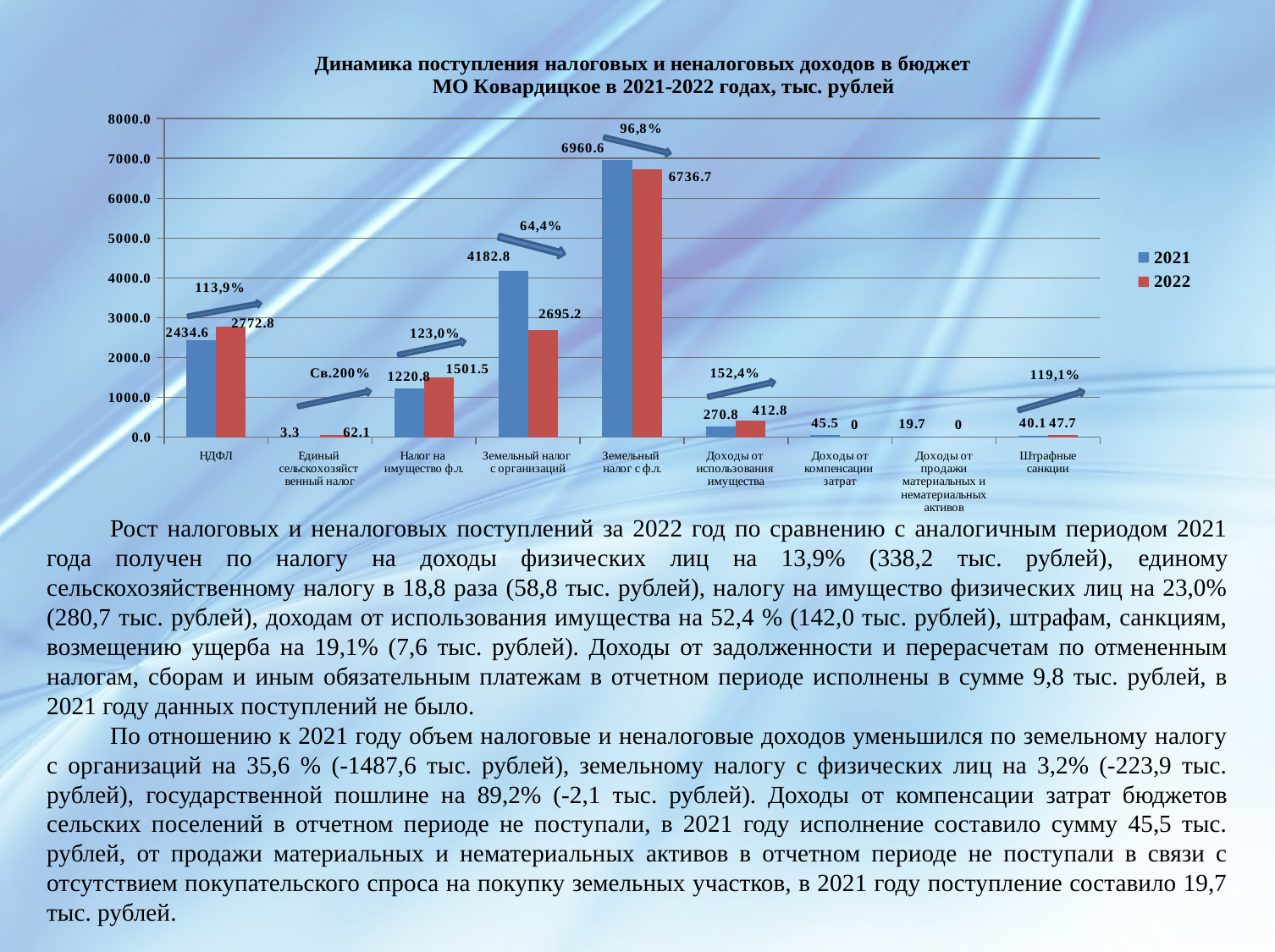
Is the 2022 value for Земельный налог с ф.л. greater or less than 6000.0? greater Which category has the highest 2021 value? Земельный налог с ф.л. What is the 2022 value for Доходы от компенсации затрат? 0 What is the 2021 value for НДФЛ? 2434.6 How many series does the legend list? 2 Which is larger for Налог на имущество ф.л.: the 2021 value or the 2022 value? 2022 How many categories are shown on the x axis? 9 What is the 2022 value for Доходы от использования имущества? 412.8 What kind of chart is shown on the slide? bar chart What is the difference between the 2021 and 2022 values for Земельный налог с организаций? 1487.6 What is the 2022 value for Земельный налог с организаций? 2695.2 Which category has the lowest 2021 value? Единый сельскохозяйственный налог